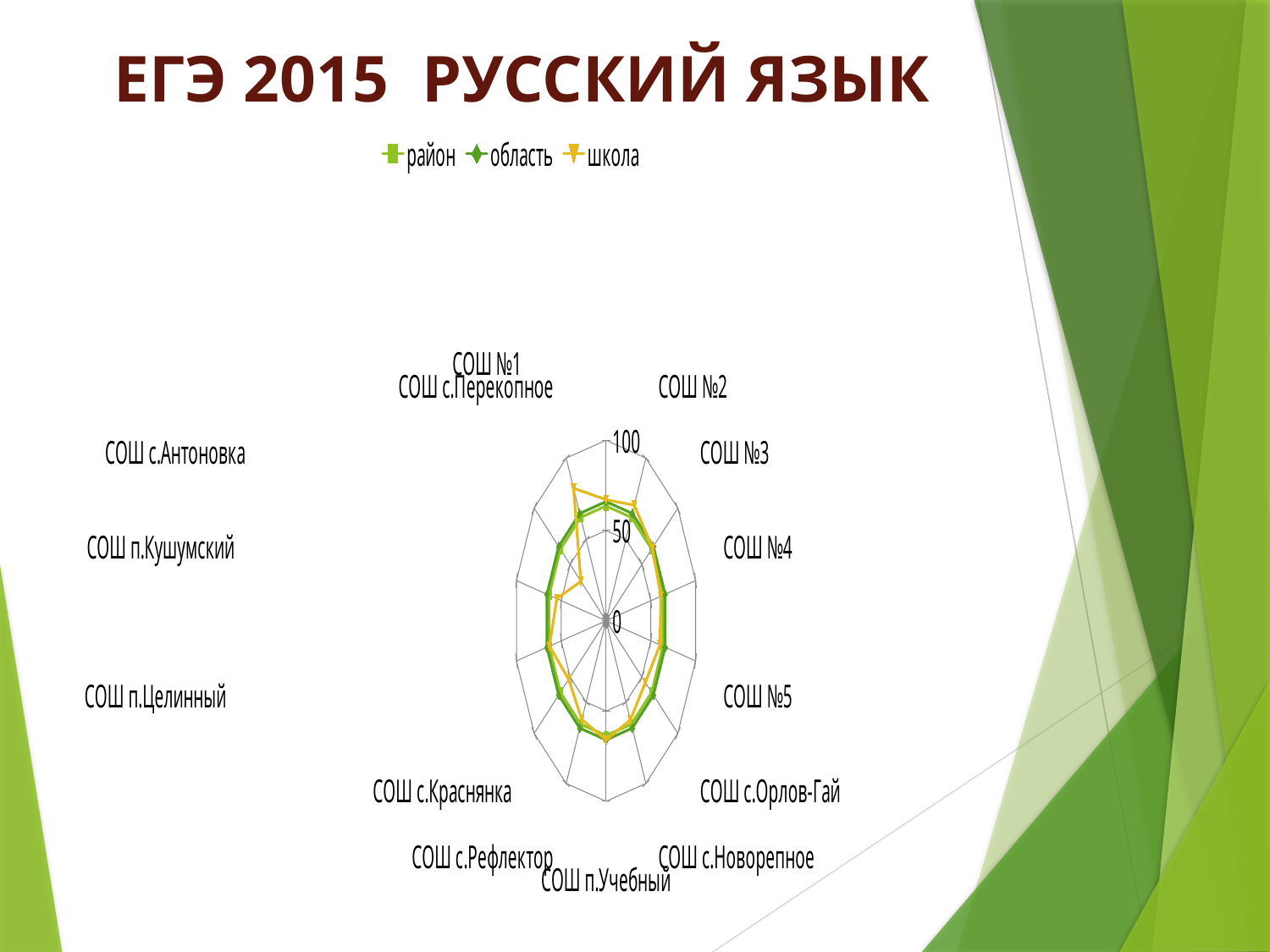
What kind of chart is shown on the slide? radar chart For which category does the школа series reach its highest value? СОШ с.Перекопное Is the value of the область series for СОШ №5 greater or less than 100? less How many series does the legend list? 3 How many categories (schools) are plotted on the radar chart? 14 Is the value of the школа series for СОШ с.Антоновка greater or less than 50? less What are the series named in the legend? район, область, школа Is the value of the школа series for СОШ с.Перекопное greater or less than 50? greater What is the title of the slide containing the chart? ЕГЭ 2015 РУССКИЙ ЯЗЫК Which is larger for the школа series: the value for СОШ с.Перекопное or the value for СОШ с.Антоновка? СОШ с.Перекопное